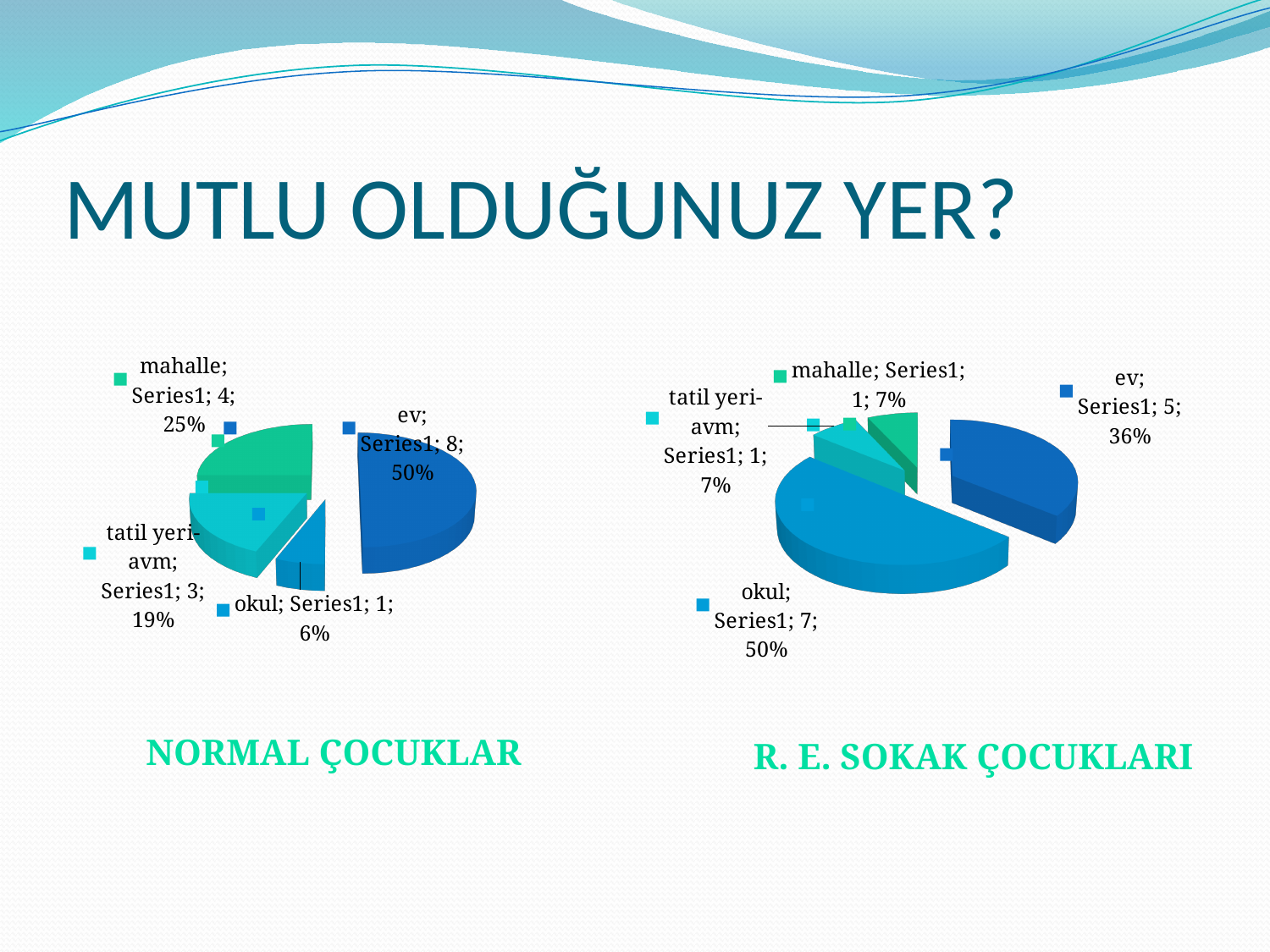
In the R. E. SOKAK ÇOCUKLARI chart, what is the value for okul? 7 How many categories are shown in the NORMAL ÇOCUKLAR chart? 4 In the NORMAL ÇOCUKLAR chart, what is the difference between the values for ev and tatil yeri-avm? 5 What is the title of the slide? MUTLU OLDUĞUNUZ YER? In the NORMAL ÇOCUKLAR chart, what is the value for ev? 8 In the NORMAL ÇOCUKLAR chart, which category has the smallest slice? okul In the R. E. SOKAK ÇOCUKLARI chart, which category has the largest slice? okul What type of chart is used for NORMAL ÇOCUKLAR? Pie chart In the NORMAL ÇOCUKLAR chart, what share of the pie does mahalle have? 25% In the R. E. SOKAK ÇOCUKLARI chart, what is the difference between the values for okul and ev? 2 In the R. E. SOKAK ÇOCUKLARI chart, what share of the pie does ev have? 36% In the R. E. SOKAK ÇOCUKLARI chart, which is larger, the value for ev or the value for mahalle? ev